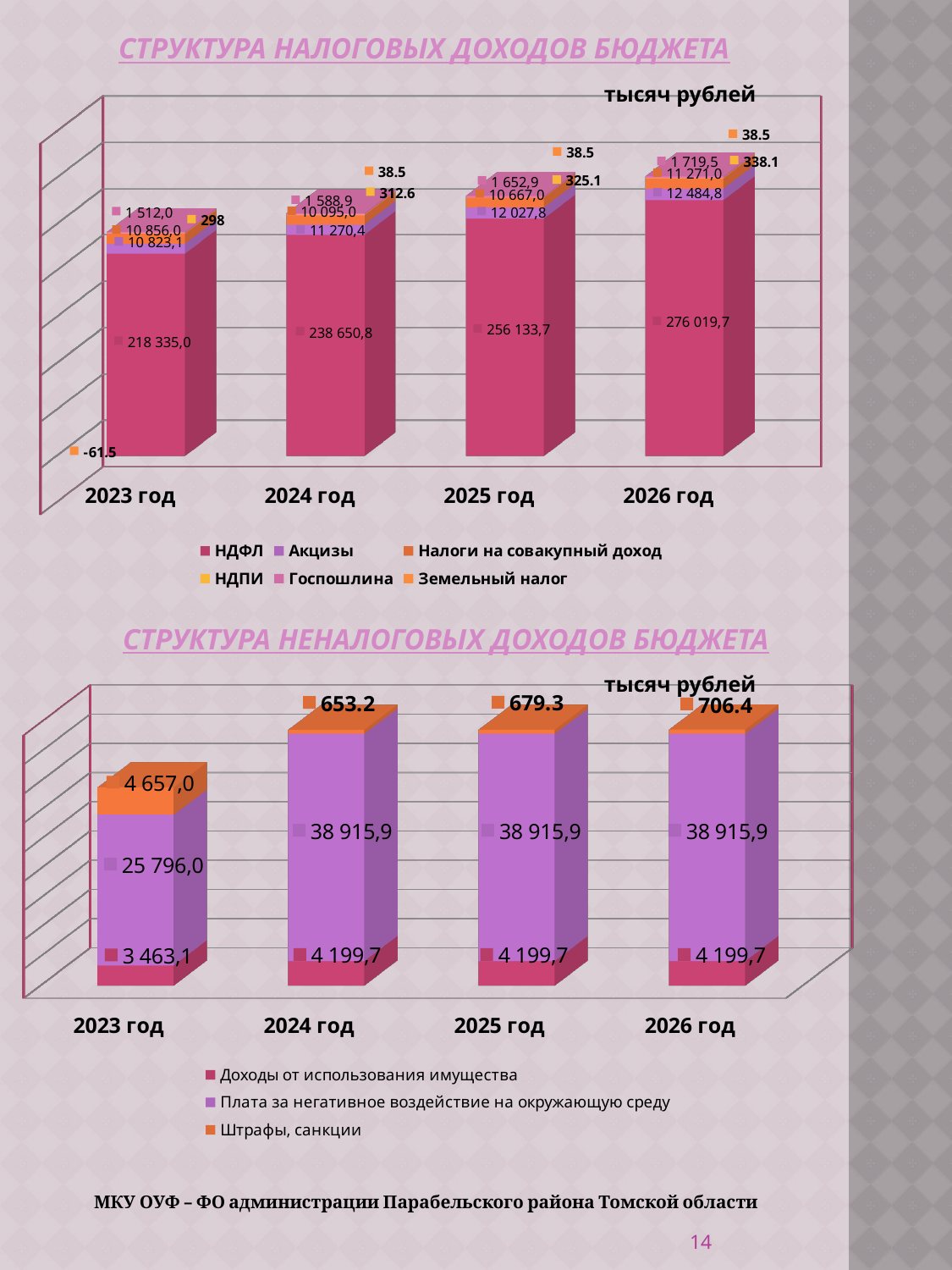
On the chart titled 'СТРУКТУРА НАЛОГОВЫХ ДОХОДОВ БЮДЖЕТА', what is the value of Акцизы for 2025 год? 12 027,8 On the chart titled 'СТРУКТУРА НАЛОГОВЫХ ДОХОДОВ БЮДЖЕТА', does НДФЛ rise or fall from 2023 год to 2026 год? rise On the chart titled 'СТРУКТУРА НЕНАЛОГОВЫХ ДОХОДОВ БЮДЖЕТА', how many years are shown on the x axis? 4 On the chart titled 'СТРУКТУРА НАЛОГОВЫХ ДОХОДОВ БЮДЖЕТА', what is the value of НДФЛ for 2023 год? 218 335,0 On the chart titled 'СТРУКТУРА НАЛОГОВЫХ ДОХОДОВ БЮДЖЕТА', what is the value of НДФЛ for 2026 год? 276 019,7 On the chart titled 'СТРУКТУРА НАЛОГОВЫХ ДОХОДОВ БЮДЖЕТА', how many series does the legend list? 6 On the chart titled 'СТРУКТУРА НЕНАЛОГОВЫХ ДОХОДОВ БЮДЖЕТА', what is the value of Штрафы, санкции for 2023 год? 4 657,0 On the chart titled 'СТРУКТУРА НЕНАЛОГОВЫХ ДОХОДОВ БЮДЖЕТА', which is larger: Штрафы, санкции in 2023 год or in 2026 год? 2023 год On the chart titled 'СТРУКТУРА НЕНАЛОГОВЫХ ДОХОДОВ БЮДЖЕТА', what is the total of the stacked bar for 2023 год? 33 916,1 On the chart titled 'СТРУКТУРА НАЛОГОВЫХ ДОХОДОВ БЮДЖЕТА', what is the difference between the НДФЛ value for 2026 год and for 2023 год? 57 684,7 On the chart titled 'СТРУКТУРА НАЛОГОВЫХ ДОХОДОВ БЮДЖЕТА', in which year is НДФЛ highest? 2026 год On the chart titled 'СТРУКТУРА НЕНАЛОГОВЫХ ДОХОДОВ БЮДЖЕТА', what is the value of Плата за негативное воздействие на окружающую среду for 2024 год? 38 915,9